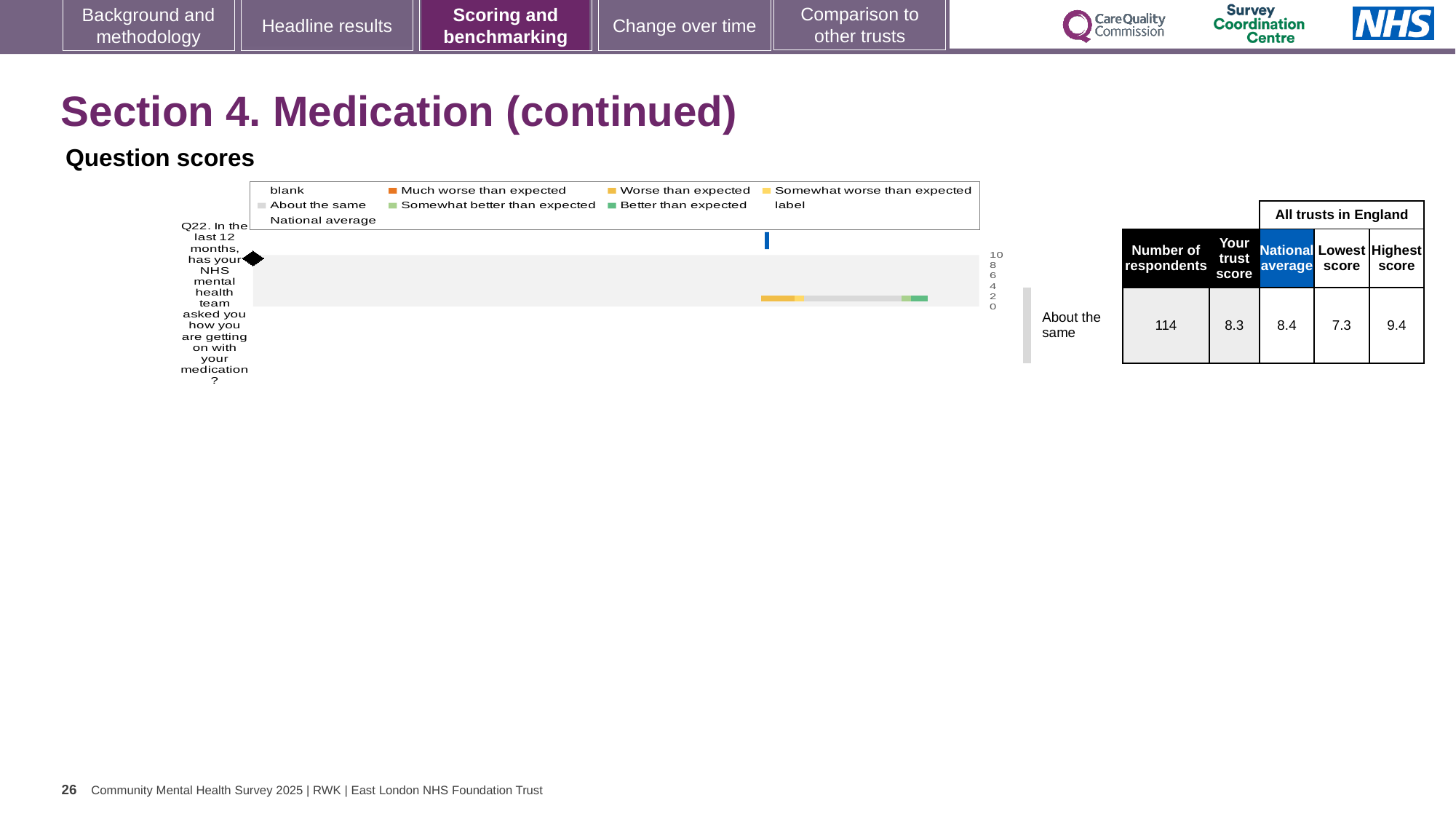
What is the national average score for Q22? 8.4 What is the difference between the highest score and the lowest score for Q22? 2.1 What benchmark category is given for Q22 on the chart? About the same What kind of chart is used to show the Q22 question score? bar chart What is the lowest score among all trusts in England for Q22? 7.3 Which legend entry is shown in orange on the question scores chart? Much worse than expected How many respondents answered Q22? 114 What is the highest value shown on the chart's score axis? 10 What is the trust score for Q22 shown next to the chart? 8.3 Which is larger for Q22, the trust score or the national average? National average What is the highest score among all trusts in England for Q22? 9.4 How many questions are plotted on the question scores chart? 1